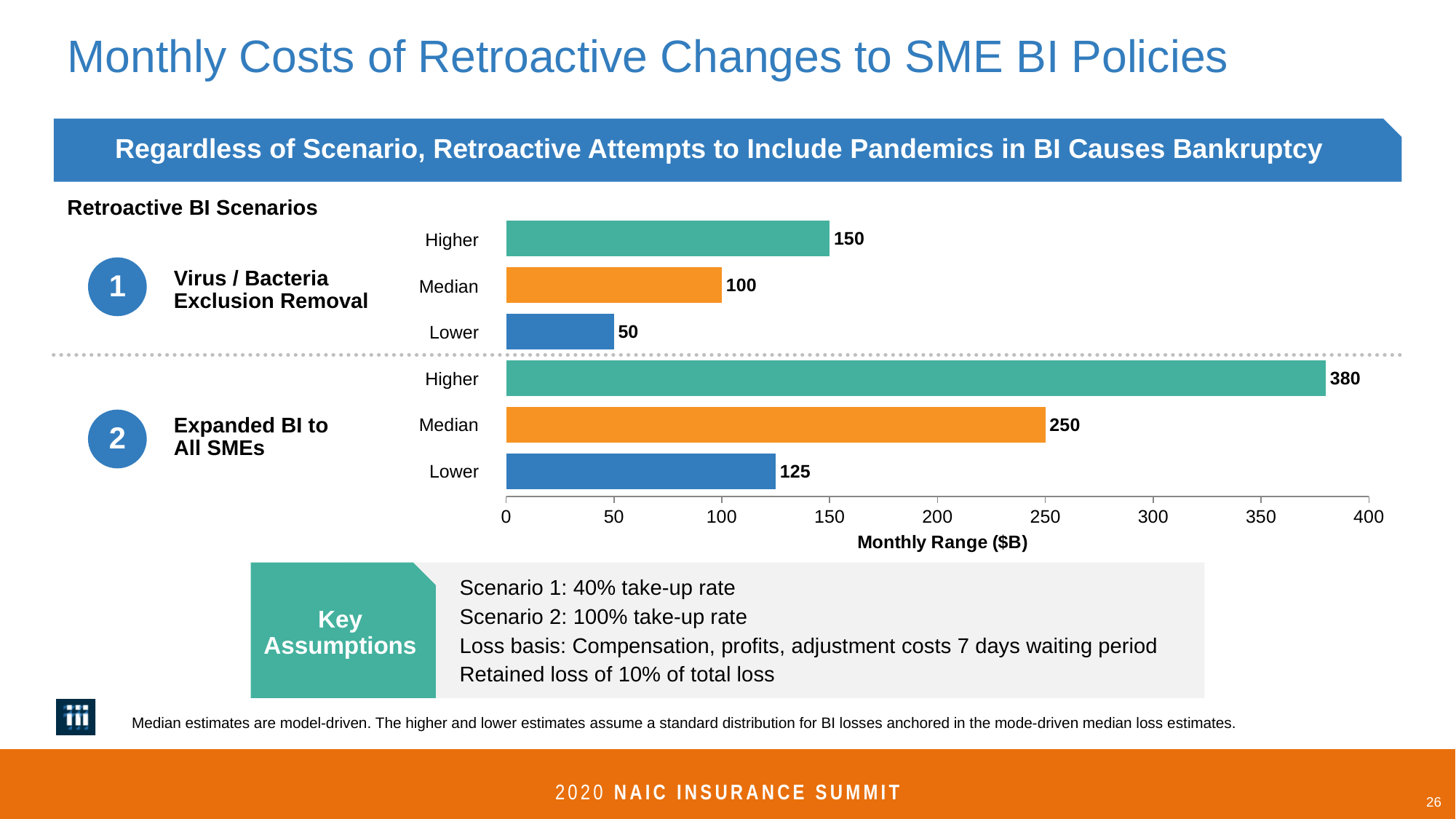
Which bar has the highest value on the chart? Higher, Expanded BI to All SMEs (380) What kind of chart is shown on the slide? Bar chart What is the maximum value shown on the horizontal axis? 400 Which is larger: the Lower estimate for Expanded BI to All SMEs or the Median estimate for Virus / Bacteria Exclusion Removal? Lower estimate for Expanded BI to All SMEs Which bar has the lowest value on the chart? Lower, Virus / Bacteria Exclusion Removal (50) What is the difference between the Higher estimates of scenario 2 and scenario 1? 230 What is the Median estimate for the Expanded BI to All SMEs scenario? 250 What is the difference between the Median and Lower estimates for the Virus / Bacteria Exclusion Removal scenario? 50 What is the label of the horizontal axis of the chart? Monthly Range ($B) What is the Higher estimate for the Virus / Bacteria Exclusion Removal scenario? 150 What is the Lower estimate for the Expanded BI to All SMEs scenario? 125 How many bars are plotted on the chart? 6